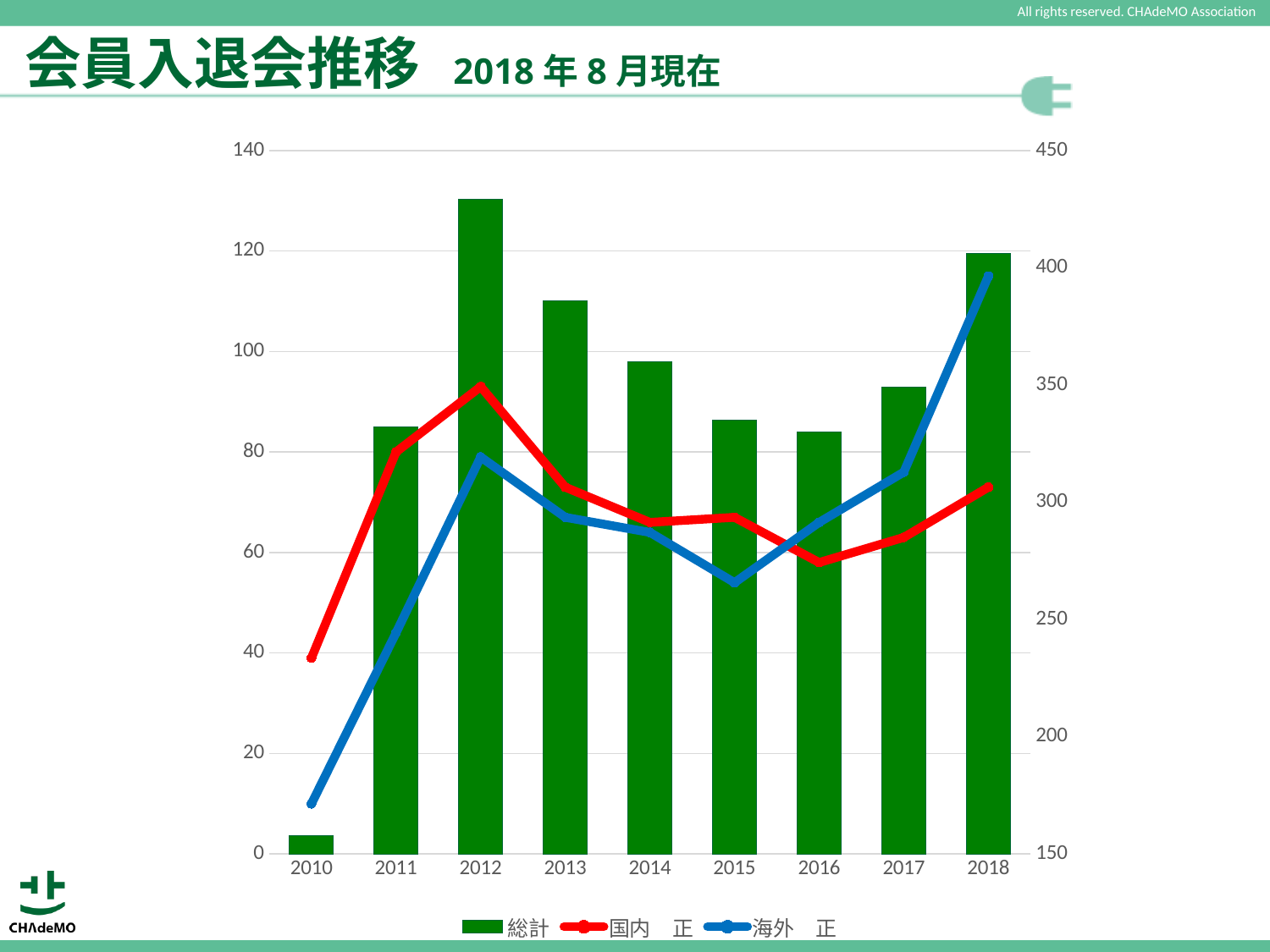
In which year does the 国内 正 line reach its highest point? 2012 In 2018, which line is higher, 国内 正 or 海外 正? 海外 正 Does the 海外 正 line rise or fall from 2015 to 2018? Rises Which year has the taller 総計 bar, 2017 or 2018? 2018 Which year has the taller 総計 bar, 2013 or 2014? 2013 What colour are the 総計 bars? Green How many years are shown on the x axis? 9 In which year is the 海外 正 line at its lowest point? 2010 What kind of chart is shown on the slide? A combined bar and line chart In which year is the 総計 bar the tallest? 2012 How many series does the legend list? 3 In which year is the 総計 bar the shortest? 2010